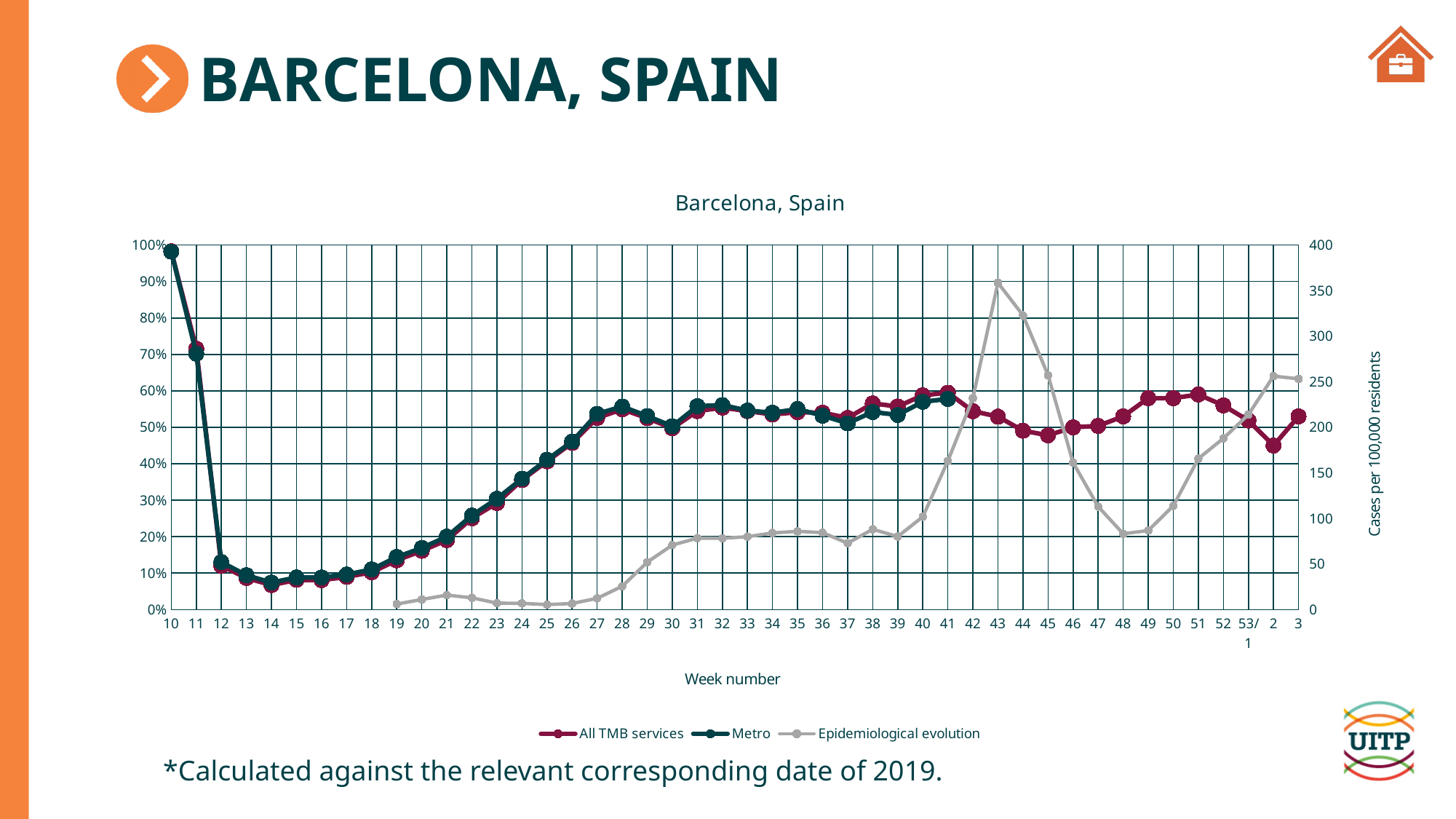
What are the three series named in the legend? All TMB services, Metro, Epidemiological evolution Is the value for Metro at week 10 greater or less than 90%? greater How many series does the legend list? 3 Is the value for All TMB services at week 14 greater or less than 10%? less What kind of chart is shown on the slide? Line chart Is the value for Epidemiological evolution at week 48 greater or less than 100? less What is the label of the right-hand vertical axis? Cases per 100,000 residents Does the Metro series rise or fall between week 14 and week 27? rise Which is larger for Epidemiological evolution: the value at week 43 or the value at week 2? week 43 At which week does the Epidemiological evolution series reach its highest value? 43